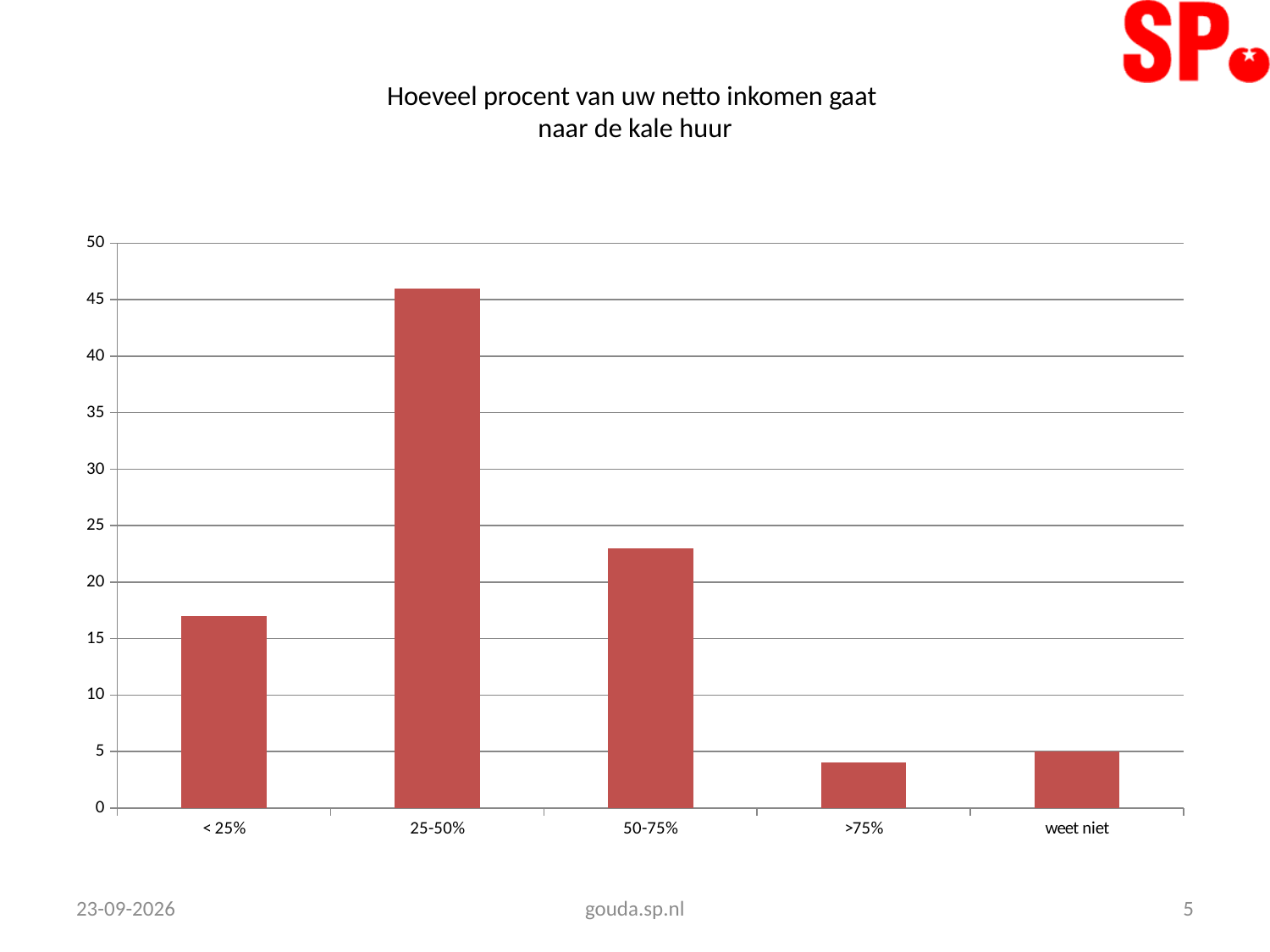
What is the value for the category 'weet niet'? 5 Which is larger, the value for < 25% or the value for 50-75%? 50-75% Is the value for >75% greater or less than 5? less Which is larger, the value for 25-50% or the value for 50-75%? 25-50% How many categories are shown on the x axis of the chart? 5 Which category has the lowest bar in the chart? >75% What is the title of the chart? Hoeveel procent van uw netto inkomen gaat naar de kale huur Is the value for 25-50% greater or less than 40? greater Is the value for 50-75% greater or less than 20? greater What kind of chart is shown on the slide? bar chart Which category has the highest bar in the chart? 25-50%